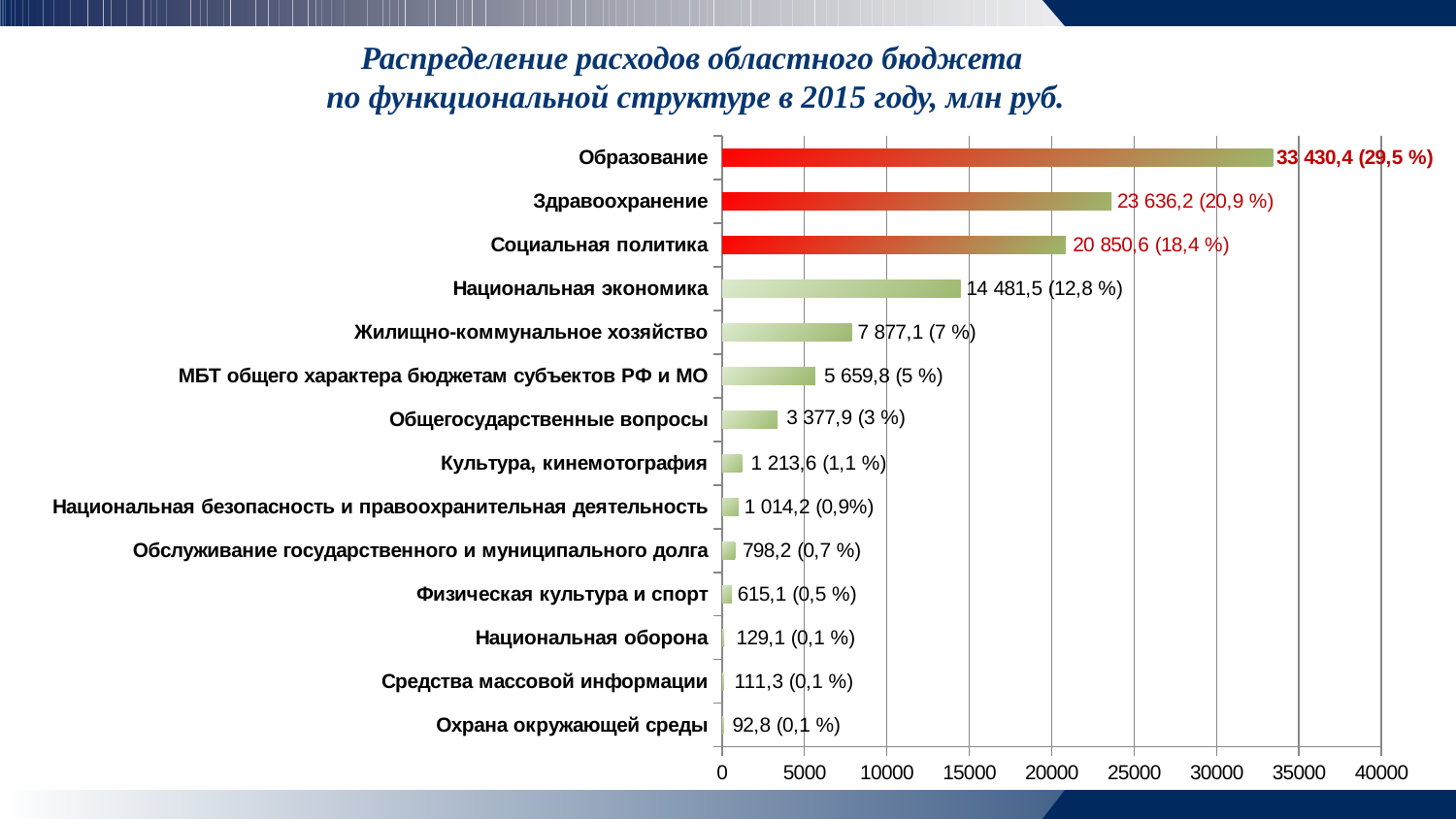
Which category has the lowest value? Охрана окружающей среды What is the value shown for Жилищно-коммунальное хозяйство? 7 877,1 (7 %) How many categories are shown in the chart? 14 Do the values increase or decrease going from the top category to the bottom category? Decrease Which category has the highest value? Образование Which is larger: the value for Социальная политика or the value for Национальная экономика? Социальная политика What is the value shown for Здравоохранение? 23 636,2 (20,9 %) What is the difference between the values for Образование and Здравоохранение (in млн руб.)? 9 794,2 What is the value shown for Образование? 33 430,4 (29,5 %) What percentage share is shown for Национальная экономика? 12,8 % Is the value for Социальная политика greater or less than 20000? greater What type of chart is shown on the slide? Bar chart